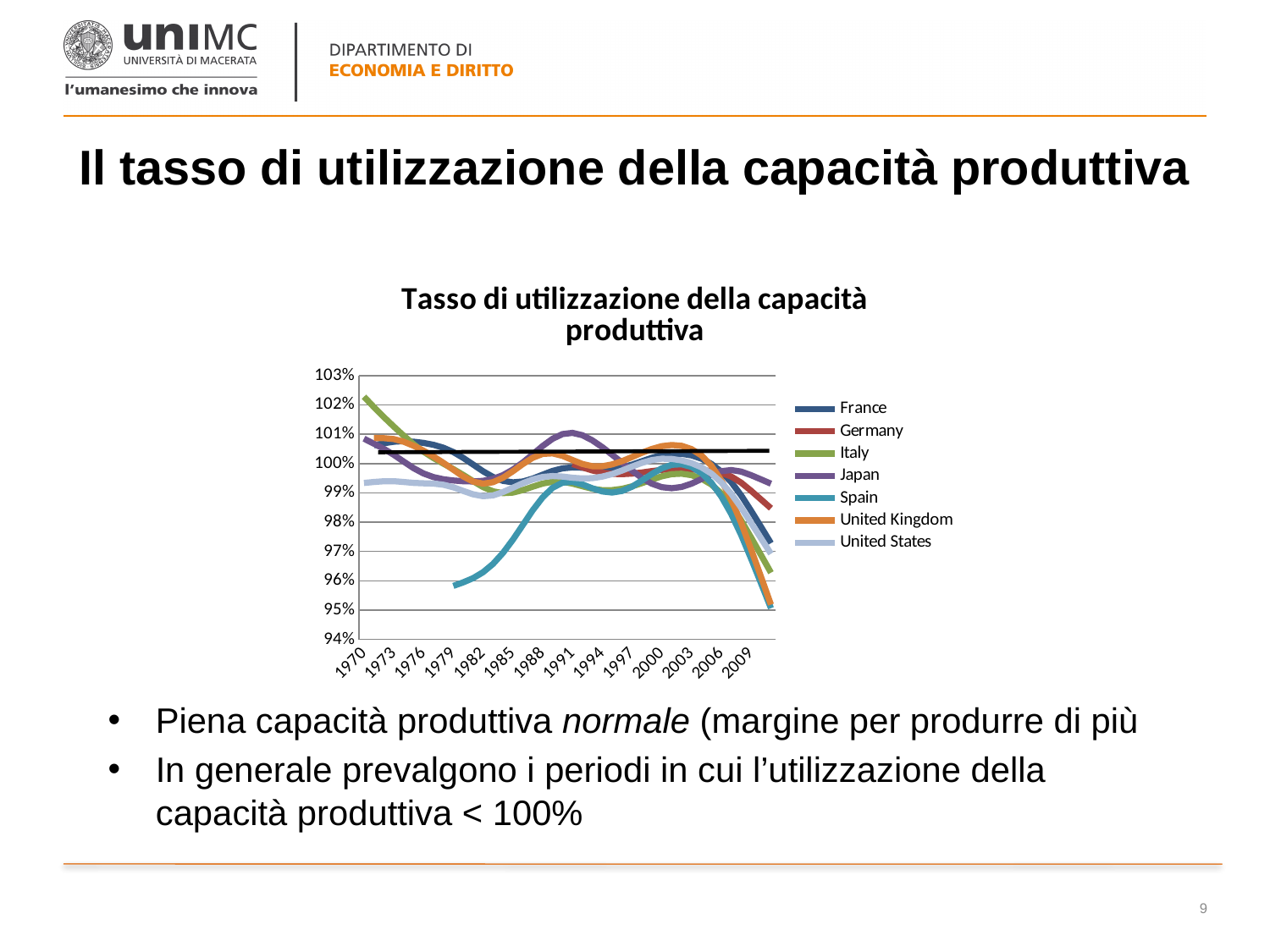
Is the value for Spain in 2009 greater or less than 96%? greater Which series has the highest value in 1970? Italy What kind of chart is shown on the slide? line chart Does the value for Spain rise or fall between 1979 and 1991? rise Which series has the lowest value in 1979? Spain Which series is drawn in green in the chart? Italy Is the value for Italy in 1970 greater or less than 101%? greater Is the value for Germany in 2009 greater or less than 98%? greater How many series does the legend list? 7 What is the title of the chart? Tasso di utilizzazione della capacità produttiva